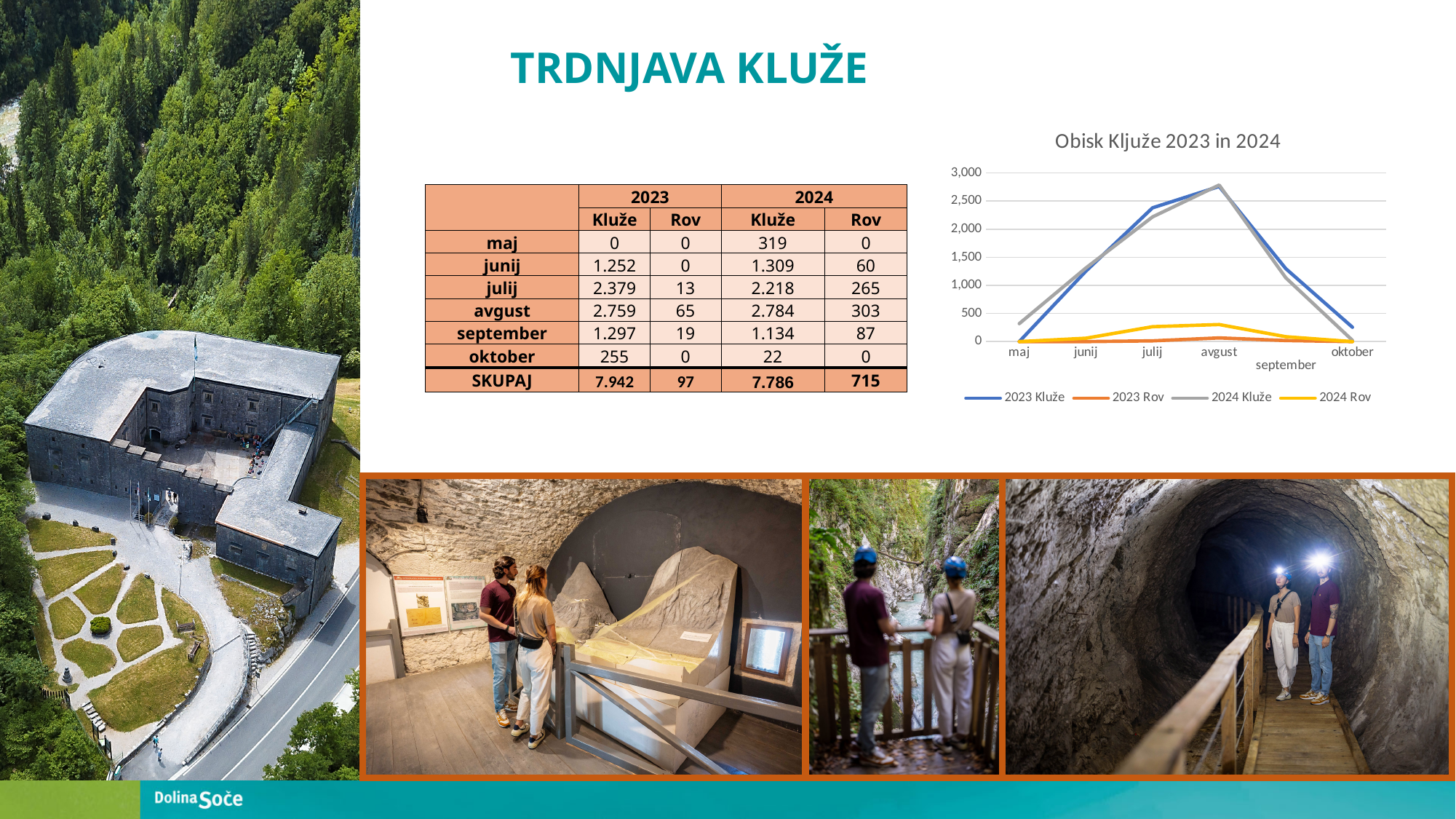
Does the 2023 Kluže series rise or fall from avgust to oktober? fall How many series does the chart legend list? 4 What is the difference between 2024 Kluže and 2023 Kluže in avgust? 25 What is the value for 2024 Kluže in avgust? 2.784 Is the value for 2024 Rov in avgust greater or less than 500? less What kind of chart is shown on the slide? line chart How many months are plotted along the x axis of the chart? 6 Is the value for 2023 Kluže in julij greater or less than 2,000? greater In avgust, which is larger: 2023 Rov or 2024 Rov? 2024 Rov In which month is the 2024 Kluže series at its lowest? oktober What is the title of the chart? Obisk Kljuže 2023 in 2024 In which month does the 2024 Kluže series reach its highest value? avgust